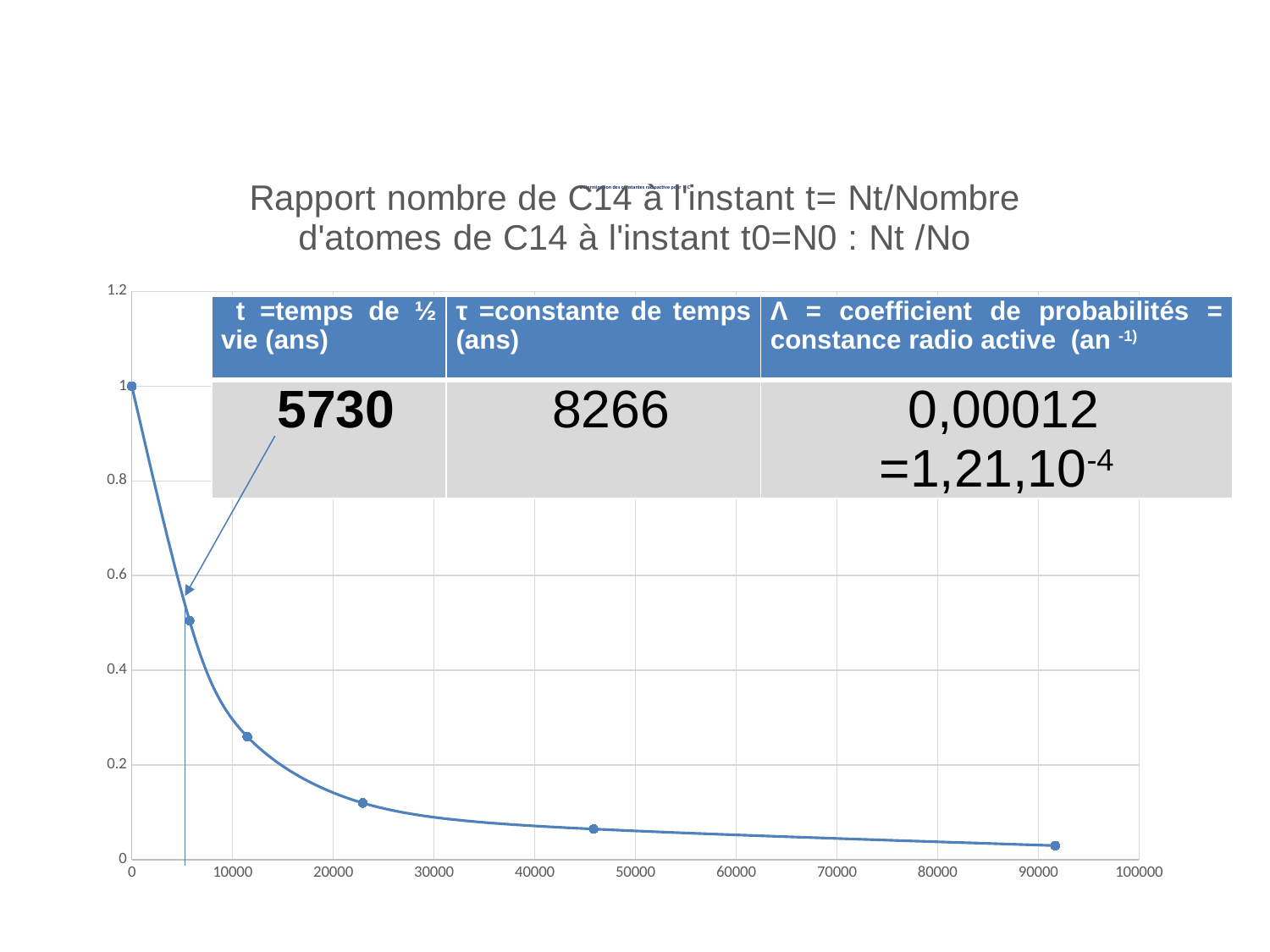
What is the highest tick value shown on the x axis? 100000 What kind of chart is shown on the slide? line chart Is the value of the data point near x = 90000 greater or less than 0.2? less Is the value of the second data point (near x = 5000) greater or less than 0.4? greater What is the value of the first data point, at x = 0? 1 Is the value of the data point near x = 10000 greater or less than 0.2? greater Do the plotted values rise or fall as the x axis increases? fall How many data points are plotted on the curve? 6 At which x value is the plotted value highest? 0 Which is larger: the value of the point near x = 10000 or the value of the point near x = 50000? the point near x = 10000